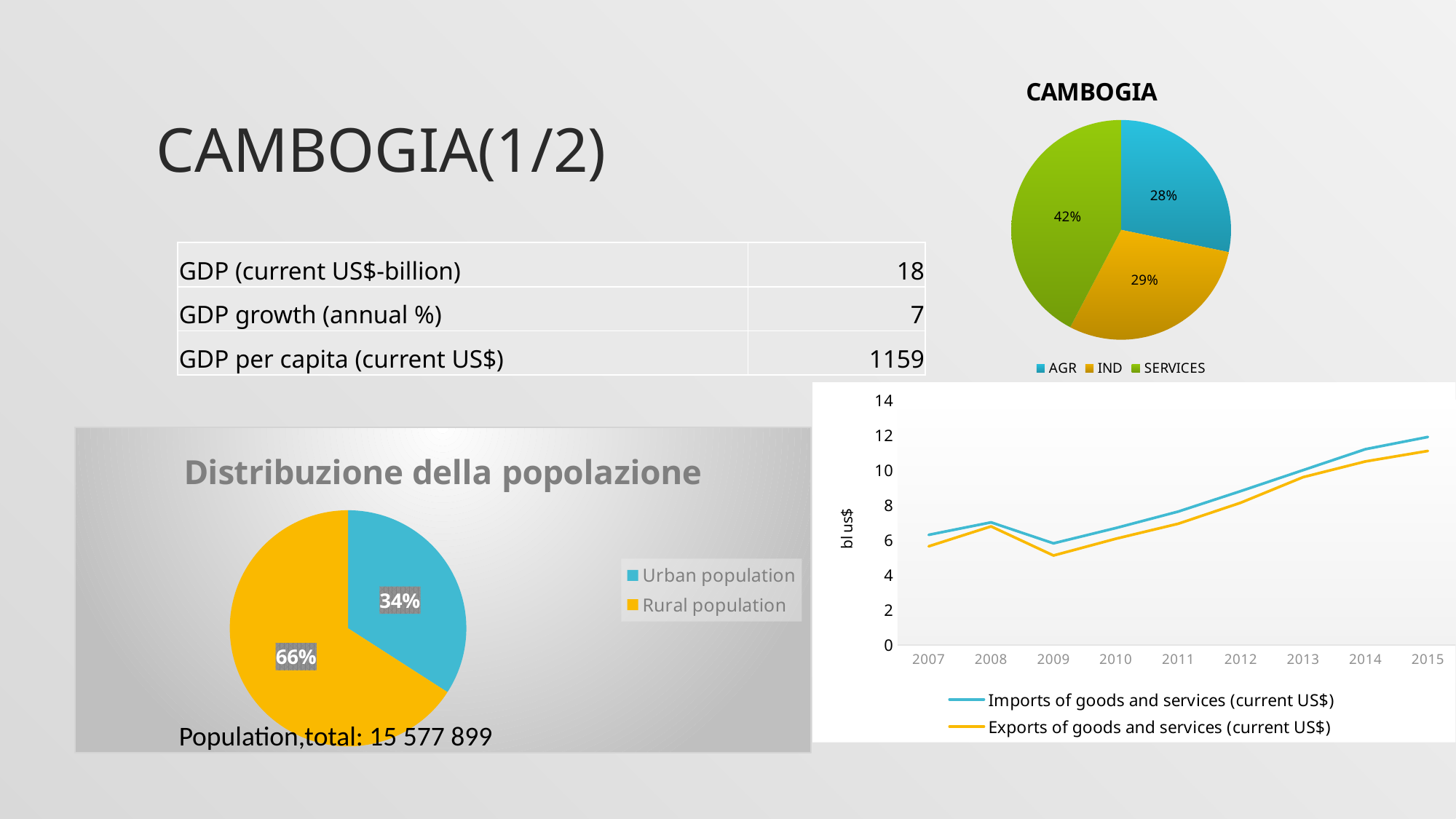
In the pie chart titled CAMBOGIA, what share does SERVICES have? 42% What kind of chart is the chart at the bottom right of the slide showing imports and exports? Line chart In the chart titled Distribuzione della popolazione, which is larger, Urban population or Rural population? Rural population In the chart titled Distribuzione della popolazione, what is the difference in percentage points between Rural population and Urban population? 32 In the pie chart titled CAMBOGIA, what share does AGR have? 28% In the pie chart titled CAMBOGIA, how many sectors does the legend list? 3 In the line chart at the bottom right, how many series does the legend list? 2 In the chart titled Distribuzione della popolazione, what share is Rural population? 66% In the pie chart titled CAMBOGIA, which sector has the smallest share? AGR In the pie chart titled CAMBOGIA, which sector has the largest share? SERVICES In the line chart at the bottom right, is the value for Imports of goods and services in 2015 greater or less than 10? greater In the pie chart titled CAMBOGIA, how many percentage points larger is SERVICES than IND? 13